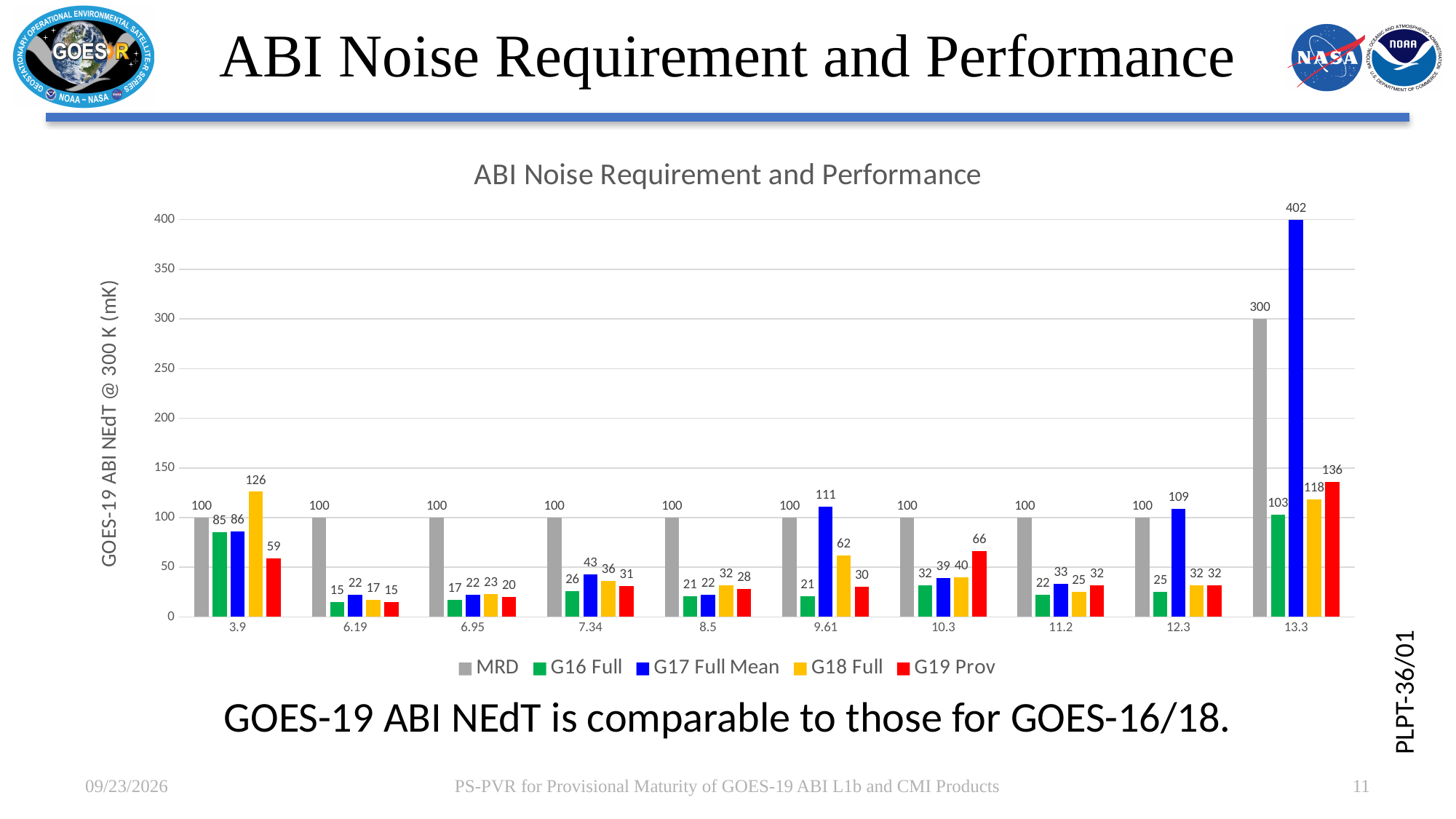
What is the G17 Full Mean value for the 13.3 band? 402 How many series does the legend list? 5 What is the MRD value for the 13.3 band? 300 What is the y-axis label of the chart? GOES-19 ABI NEdT @ 300 K (mK) For the 10.3 band, which is larger: G19 Prov or G18 Full? G19 Prov What is the G18 Full value for the 9.61 band? 62 Which band has the highest G19 Prov value? 13.3 How many bands are shown on the x axis? 10 What is the G19 Prov value for the 3.9 band? 59 Which band has the lowest G16 Full value? 6.19 What kind of chart is shown on the slide? Bar chart What is the difference between the G17 Full Mean and MRD values for the 13.3 band? 102